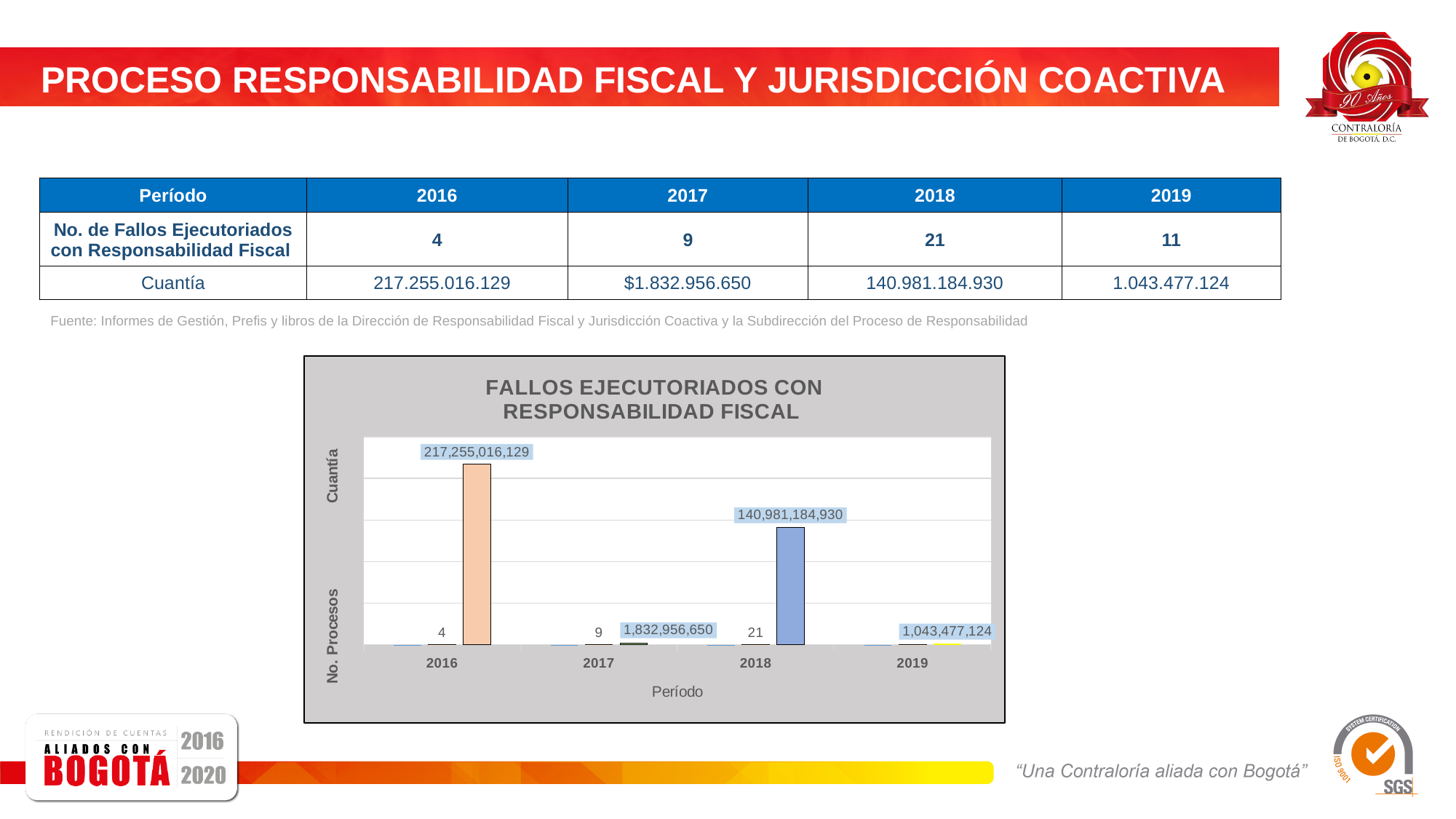
Which period has the highest Cuantía in the chart? 2016 In the chart, what is the Cuantía value labelled for 2019? 1,043,477,124 In the chart, how many processes (No. Procesos) are labelled for 2016? 4 Which period has the lowest Cuantía in the chart? 2019 What is the difference between the Cuantía for 2016 and the Cuantía for 2018 in the chart? 76,273,831,199 In the chart, what is the Cuantía value labelled for 2016? 217,255,016,129 How many periods are shown on the x axis of the chart? 4 In the chart, what is the Cuantía value labelled for 2017? 1,832,956,650 What type of chart is shown on the slide? Bar chart In the chart, how many processes (No. Procesos) are labelled for 2018? 21 In the chart, which period has the larger Cuantía, 2017 or 2018? 2018 In the chart, what is the Cuantía value labelled for 2018? 140,981,184,930